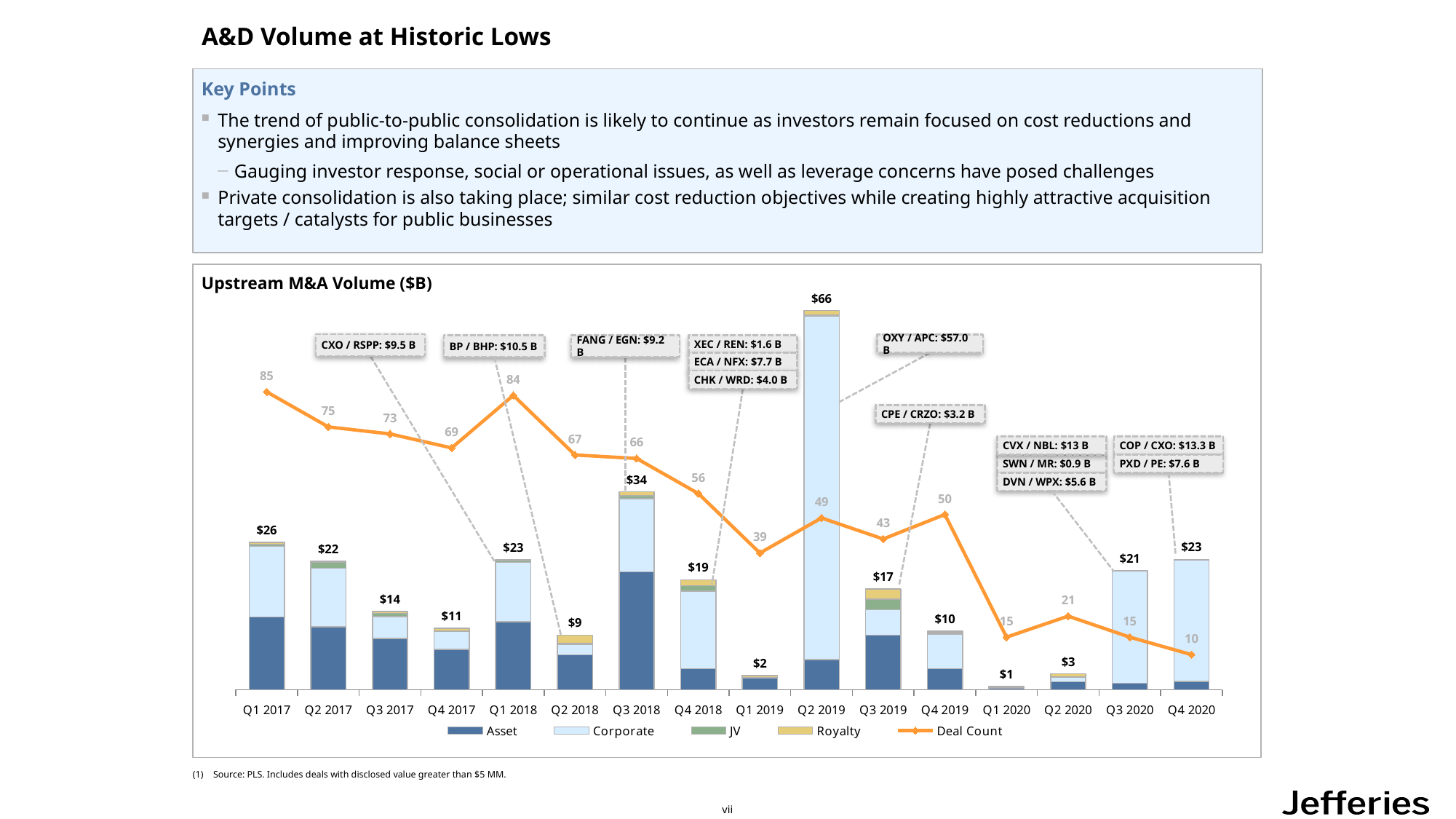
What is the difference between the deal count in Q1 2017 and Q4 2020? 75 Which quarter has the larger total volume, Q3 2020 or Q4 2020? Q4 2020 Which quarter has the lowest deal count? Q4 2020 How many series does the legend list? 5 Which quarter has the lowest total M&A volume? Q1 2020 Does the deal count line generally rise or fall from Q1 2017 to Q4 2020? Fall What is the difference between the total volume in Q3 2018 and Q4 2018? $15 How many quarters are shown on the x axis? 16 Which quarter has the highest total M&A volume? Q2 2019 What is the total upstream M&A volume shown for Q2 2019? $66 What is the deal count shown for Q1 2017? 85 What kind of chart is shown on the slide? Stacked bar chart with a line